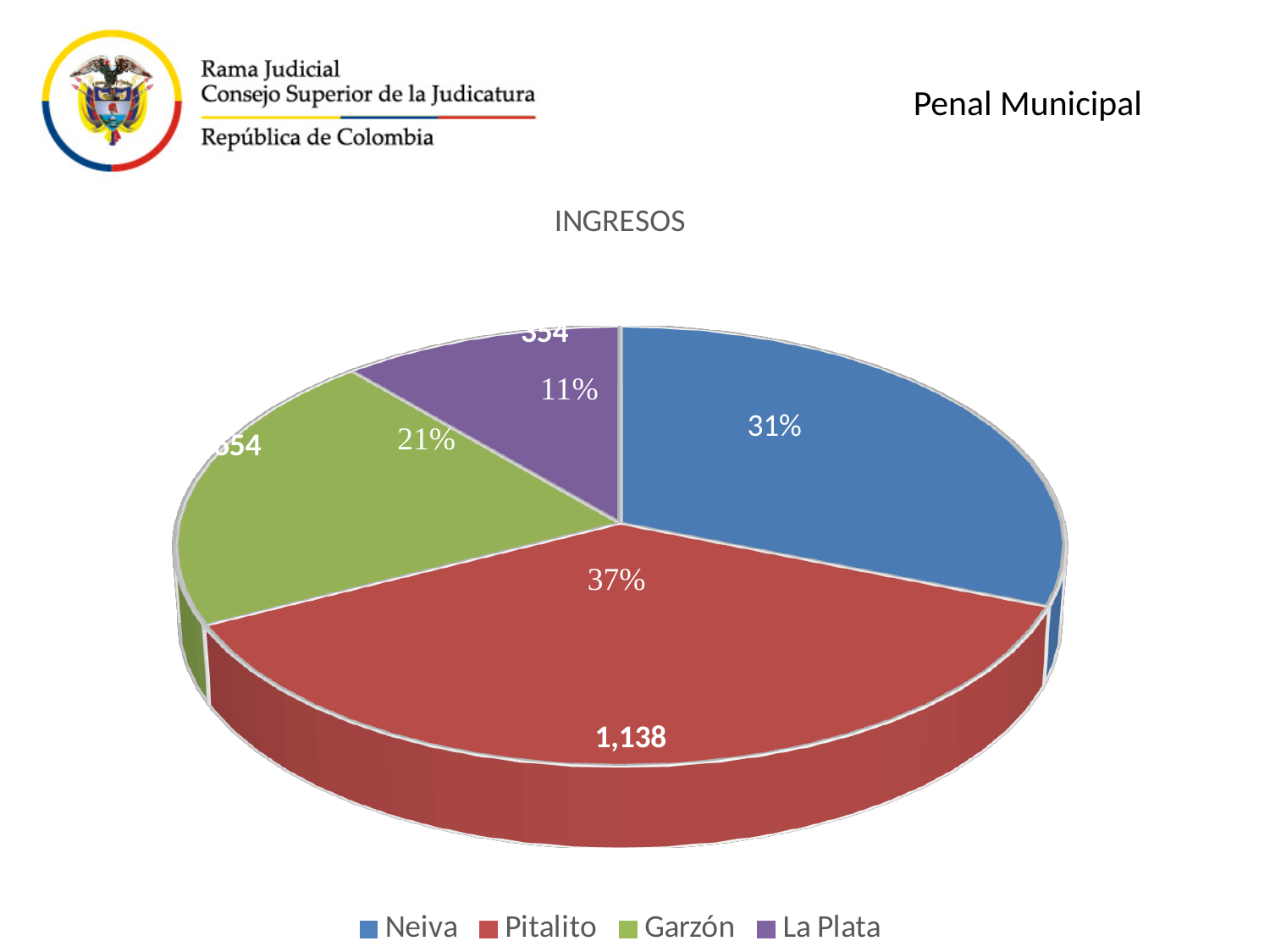
What share of the pie does La Plata represent? 11% What share of the pie does Pitalito represent? 37% How many entries does the legend list? 4 What share of the pie does Garzón represent? 21% What kind of chart is shown on the slide? pie chart What is the value shown for Pitalito? 1,138 Which category has the smallest slice of the pie? La Plata Which has a larger share, Neiva or Garzón? Neiva How many slices does the pie chart have? 4 Which category has the largest slice of the pie? Pitalito What is the title of the chart? INGRESOS